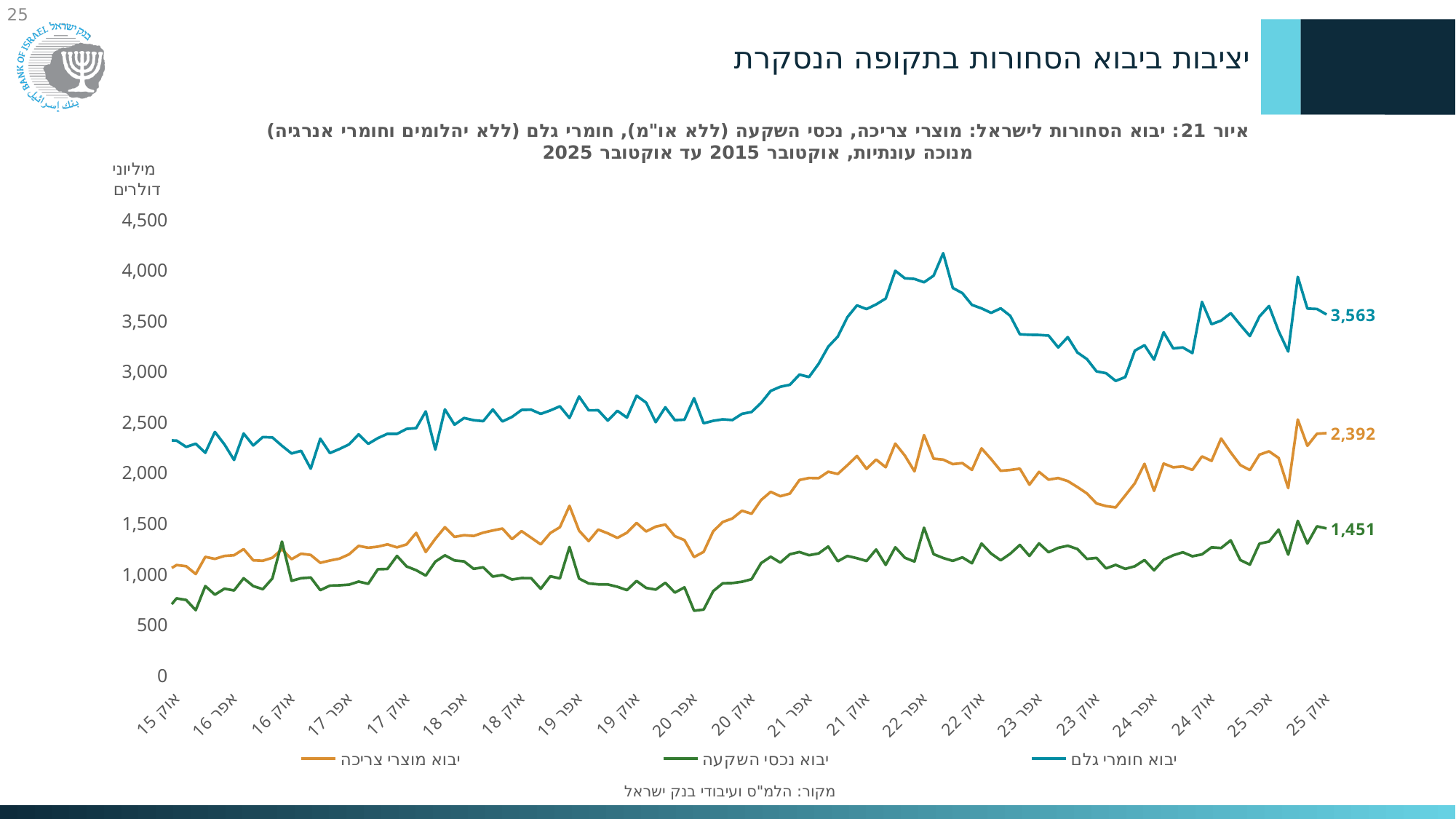
Is the value of יבוא חומרי גלם in October 2015 greater or less than 2,000? greater What is the final value shown for the series יבוא מוצרי צריכה (consumer goods imports) in October 2025? 2,392 Which series has the highest value at the end of the period (October 2025)? יבוא חומרי גלם Is the value of יבוא נכסי השקעה in October 2015 greater or less than 1,000? less Which series has the lowest value at the end of the period (October 2025)? יבוא נכסי השקעה What kind of chart is shown on the slide? Line chart At the end of the period, which is larger: יבוא מוצרי צריכה or יבוא נכסי השקעה? יבוא מוצרי צריכה What is the difference between the October 2025 values of יבוא מוצרי צריכה (2,392) and יבוא נכסי השקעה (1,451)? 941 What is the final value shown for the series יבוא נכסי השקעה (investment goods imports) in October 2025? 1,451 How many series does the legend list? 3 What is the final value shown for the series יבוא חומרי גלם (raw materials imports) in October 2025? 3,563 What is the difference between the October 2025 values of יבוא חומרי גלם (3,563) and יבוא מוצרי צריכה (2,392)? 1,171